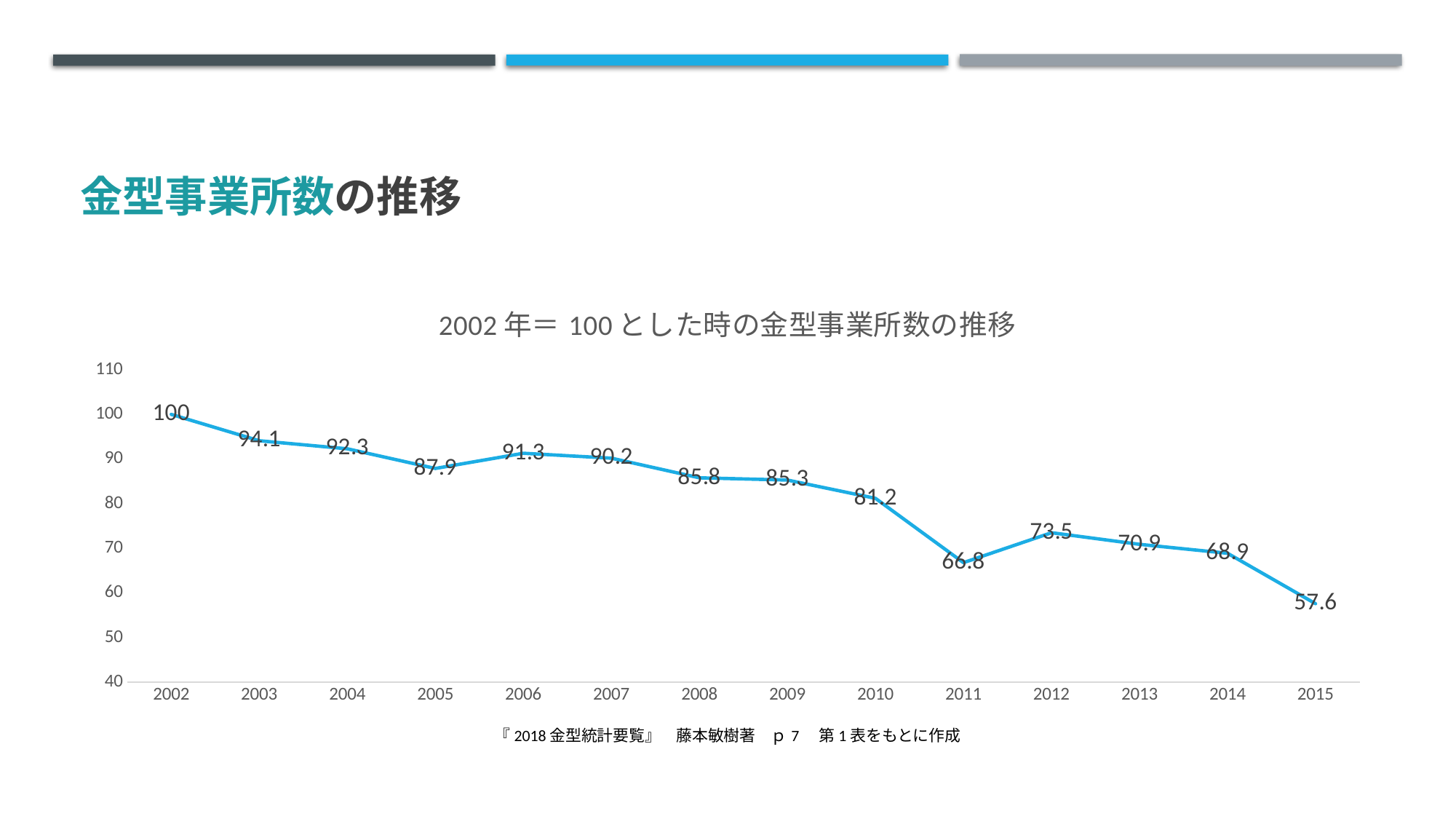
Do the values generally rise or fall from 2002 to 2015? fall Is the value for 2010 greater or less than 80? greater Which year has the highest value? 2002 Which year has the lowest value? 2015 What is the difference between the values for 2010 and 2011? 14.4 What is the value for 2015? 57.6 What is the difference between the values for 2002 and 2015? 42.4 How many years are plotted on the x axis? 14 What is the value for 2008? 85.8 Which is larger, the value for 2012 or the value for 2011? 2012 What is the value for 2011? 66.8 What kind of chart is shown? line chart